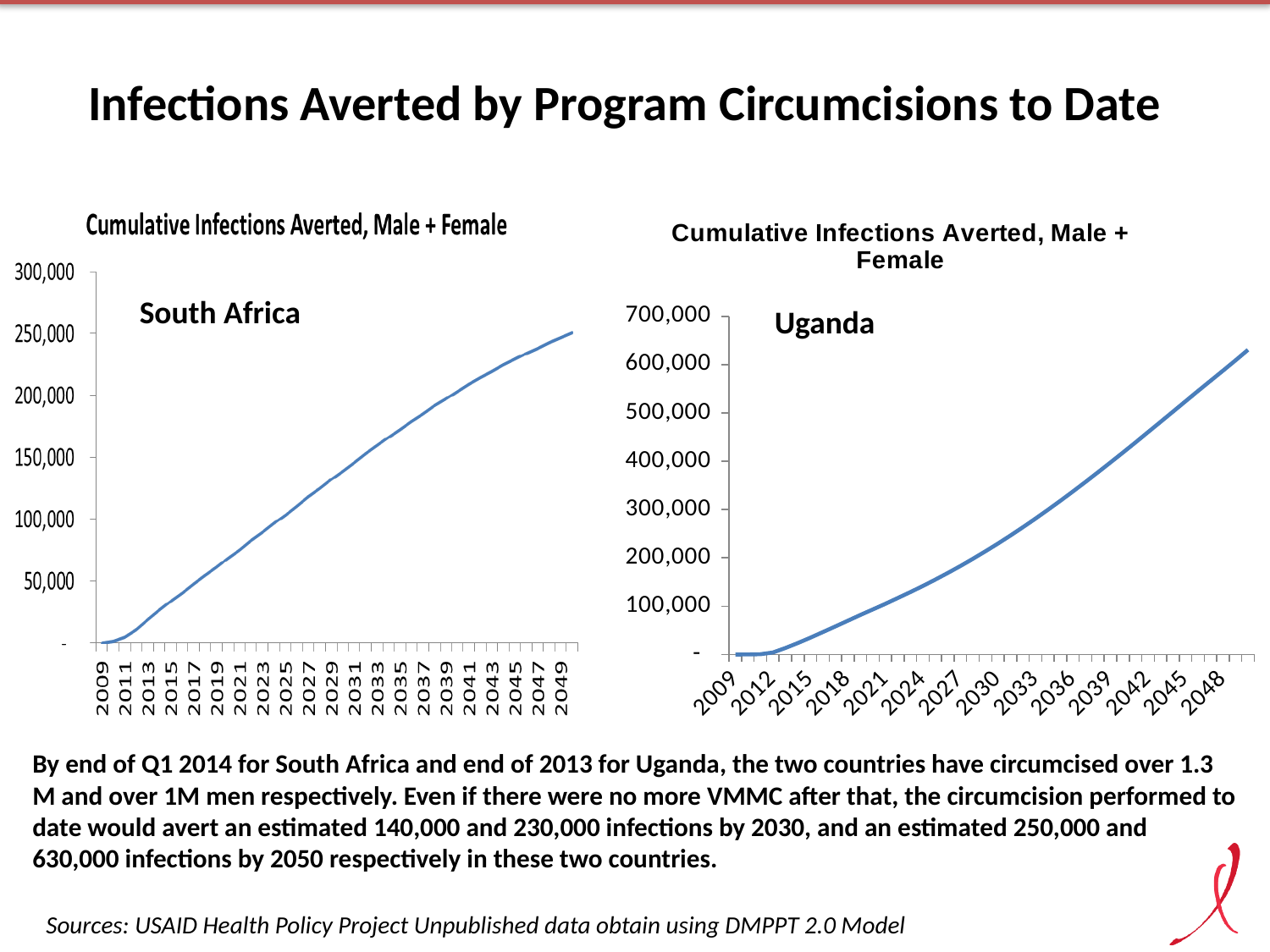
What kind of chart is the Uganda chart on the right? line chart In the Uganda chart, do the cumulative infections averted rise or fall over the years shown? rise What kind of chart is the South Africa chart on the left? line chart In the Uganda chart, is the value for 2036 greater or less than 200,000? greater In the Uganda chart, is the value for 2048 greater or less than 500,000? greater In the South Africa chart, is the value for 2049 greater or less than 200,000? greater What is the highest value shown on the y axis of the Uganda chart? 700,000 What is the title of the South Africa chart on the left? Cumulative Infections Averted, Male + Female In the South Africa chart, do the cumulative infections averted rise or fall from 2009 to 2049? rise